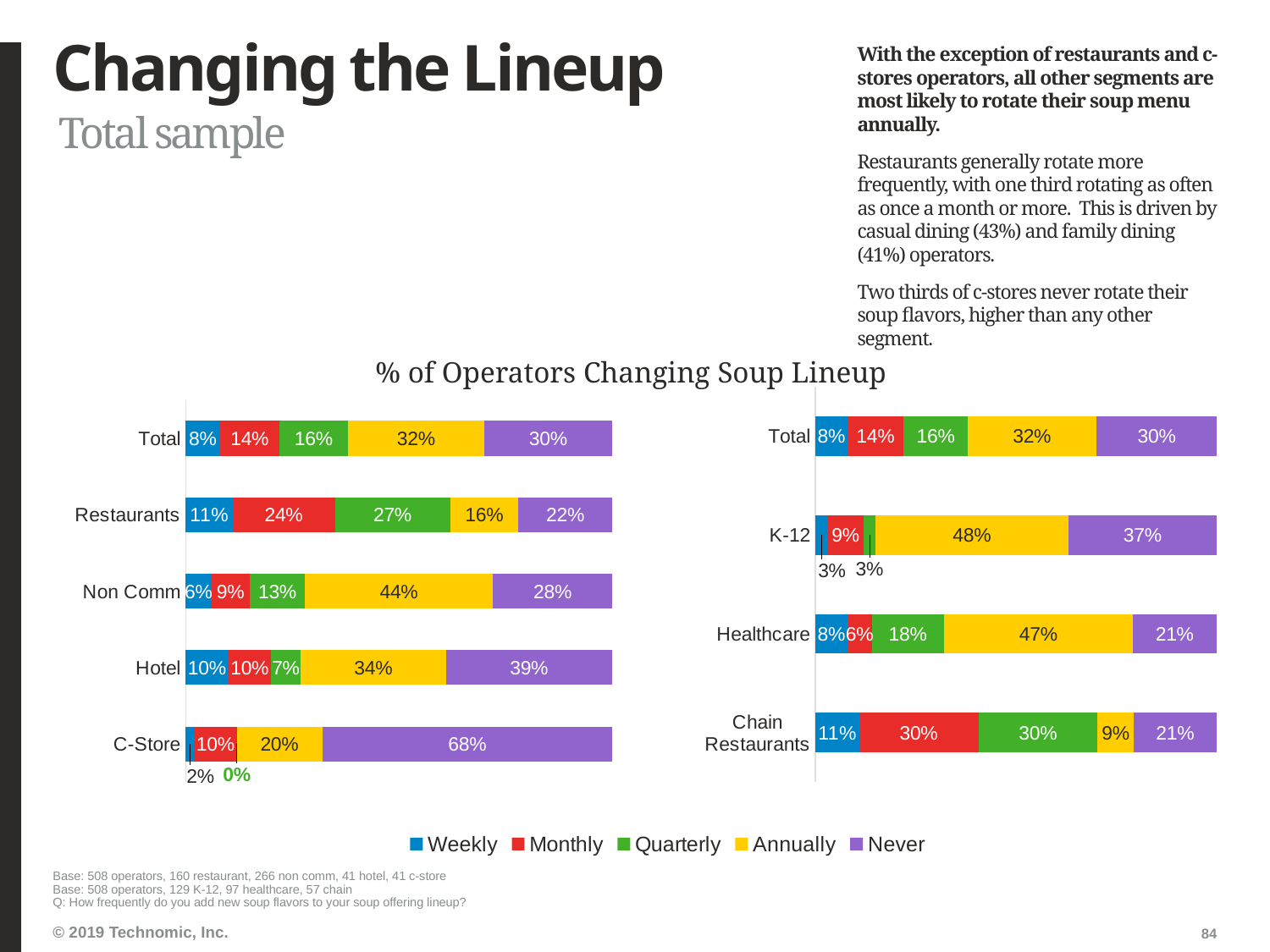
In the right chart, which category has the lowest Annually value? Chain Restaurants In the right chart, what is the Annually value for K-12? 48% How many series does the legend list? 5 In the left chart, what is the Quarterly value for Hotel? 7% In the right chart, which has a larger Quarterly value, Healthcare or K-12? Healthcare In the left chart, which category has the highest Never value? C-Store What is the title shown above the charts? % of Operators Changing Soup Lineup In the left chart, what percentage of C-Store operators never change their soup lineup? 68% How many categories are shown in the left chart? 5 What type of chart is used on this slide? Stacked bar chart In the right chart, what is the Monthly value for Chain Restaurants? 30% In the left chart, what is the difference between the Monthly value for Restaurants and the Monthly value for Total? 10 percentage points